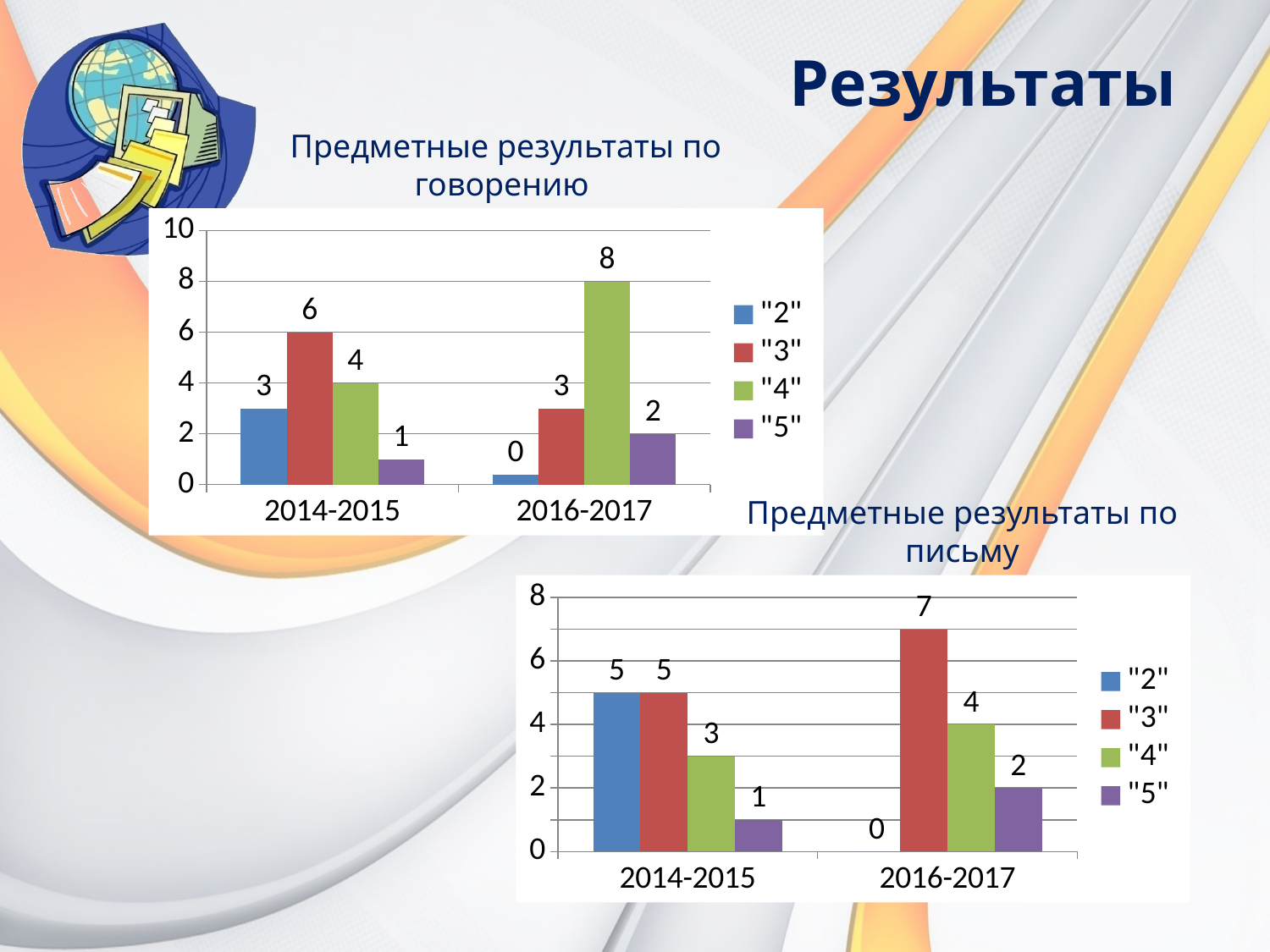
In the chart 'Предметные результаты по письму', what is the value for series "2" in 2016-2017? 0 In the chart 'Предметные результаты по письму', what is the difference between the value for series "2" in 2014-2015 and in 2016-2017? 5 In the chart 'Предметные результаты по письму', how many categories are shown on the x axis? 2 In the chart 'Предметные результаты по письму', which series has the lowest value in 2014-2015? "5" What type of chart is 'Предметные результаты по говорению'? bar chart In the chart 'Предметные результаты по письму', what is the value for series "3" in 2016-2017? 7 In the chart 'Предметные результаты по говорению', how many series does the legend list? 4 In the chart 'Предметные результаты по говорению', what is the difference between the value for series "4" in 2016-2017 and in 2014-2015? 4 In the chart 'Предметные результаты по говорению', which series has the highest value in 2016-2017? "4" In the chart 'Предметные результаты по письму', is the value for series "3" in 2016-2017 larger or smaller than the value for series "4" in 2016-2017? larger In the chart 'Предметные результаты по говорению', what is the value for series "4" in 2016-2017? 8 In the chart 'Предметные результаты по говорению', what is the value for series "3" in 2014-2015? 6